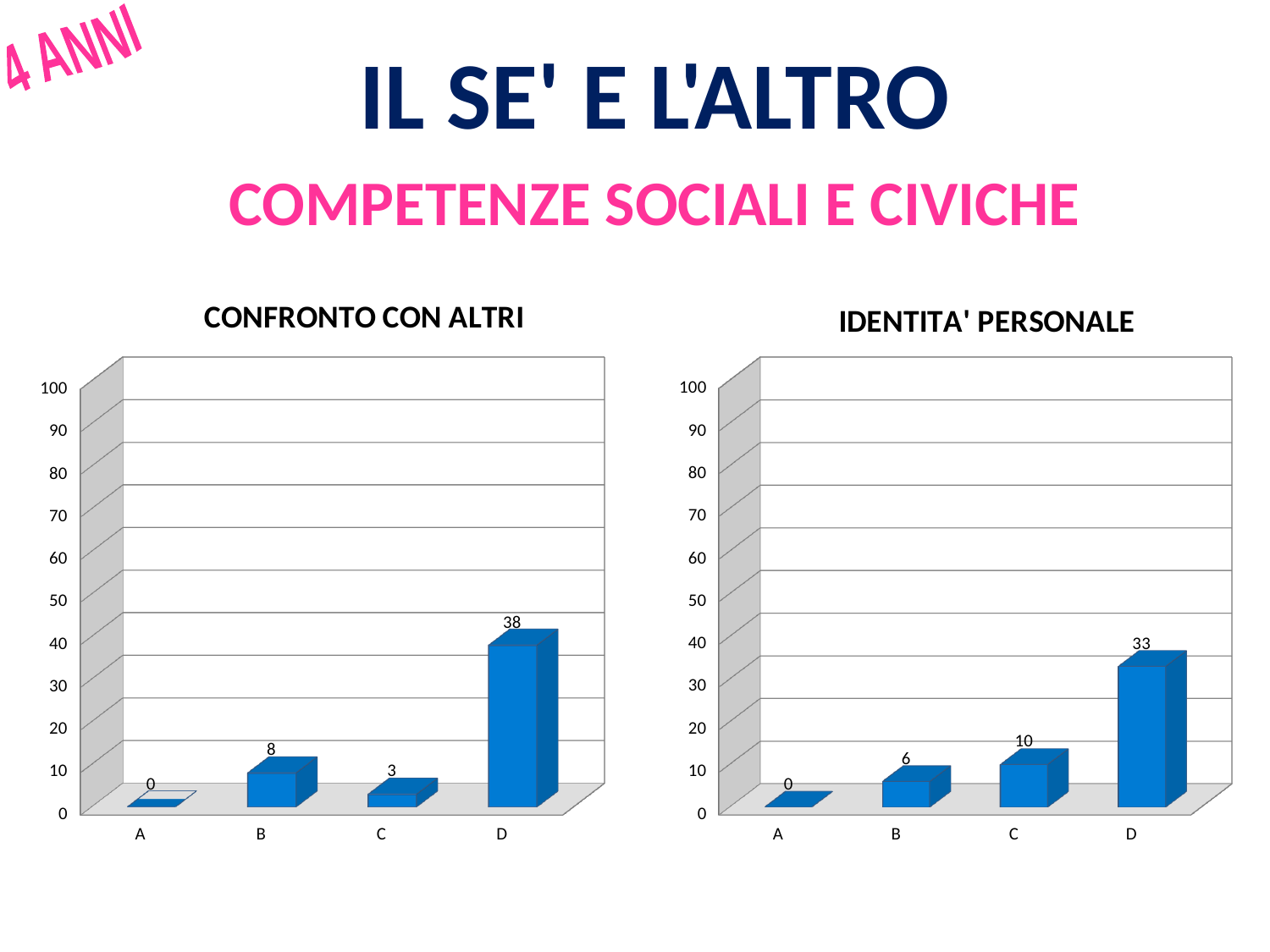
In the 'IDENTITA' PERSONALE' chart, which category has the highest value? D In the 'IDENTITA' PERSONALE' chart, what is the difference between the values for D and C? 23 What kind of chart is the 'IDENTITA' PERSONALE' chart? bar chart In the 'CONFRONTO CON ALTRI' chart, what is the difference between the values for D and B? 30 In the 'CONFRONTO CON ALTRI' chart, what is the value for category B? 8 In the 'IDENTITA' PERSONALE' chart, is the value for D greater or less than 40? less In the 'IDENTITA' PERSONALE' chart, what is the value for category C? 10 In the 'CONFRONTO CON ALTRI' chart, what is the value for category D? 38 In the 'CONFRONTO CON ALTRI' chart, which category has the lowest value? A How many categories are shown in the 'CONFRONTO CON ALTRI' chart? 4 Which is larger: the value for C in the 'CONFRONTO CON ALTRI' chart or the value for C in the 'IDENTITA' PERSONALE' chart? IDENTITA' PERSONALE What is the title of the chart on the left of the slide? CONFRONTO CON ALTRI